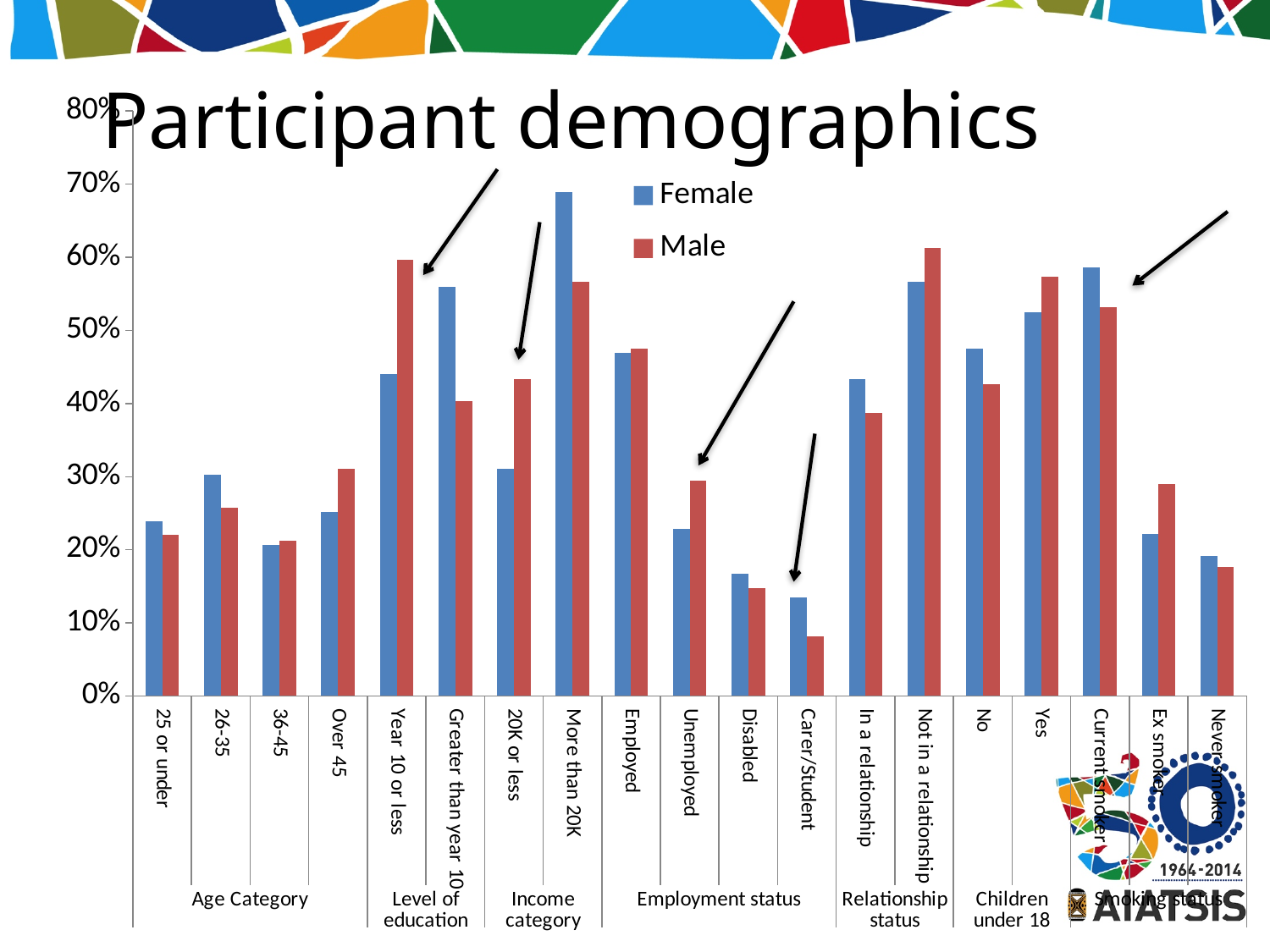
For Current smoker, which is larger, the Female value or the Male value? Female Which category has the highest Male value? Not in a relationship What kind of chart is shown on the slide? bar chart Is the Male value for Carer/Student greater or less than 10%? less Is the Female value for Not in a relationship greater or less than 50%? greater Which category has the lowest Male value? Carer/Student Is the Female value for More than 20K greater or less than 60%? greater Which colour represents the Male series in the chart? red For Year 10 or less, which is larger, the Female value or the Male value? Male Which category has the highest Female value? More than 20K How many series does the legend list? 2 What is the title of the slide's chart? Participant demographics